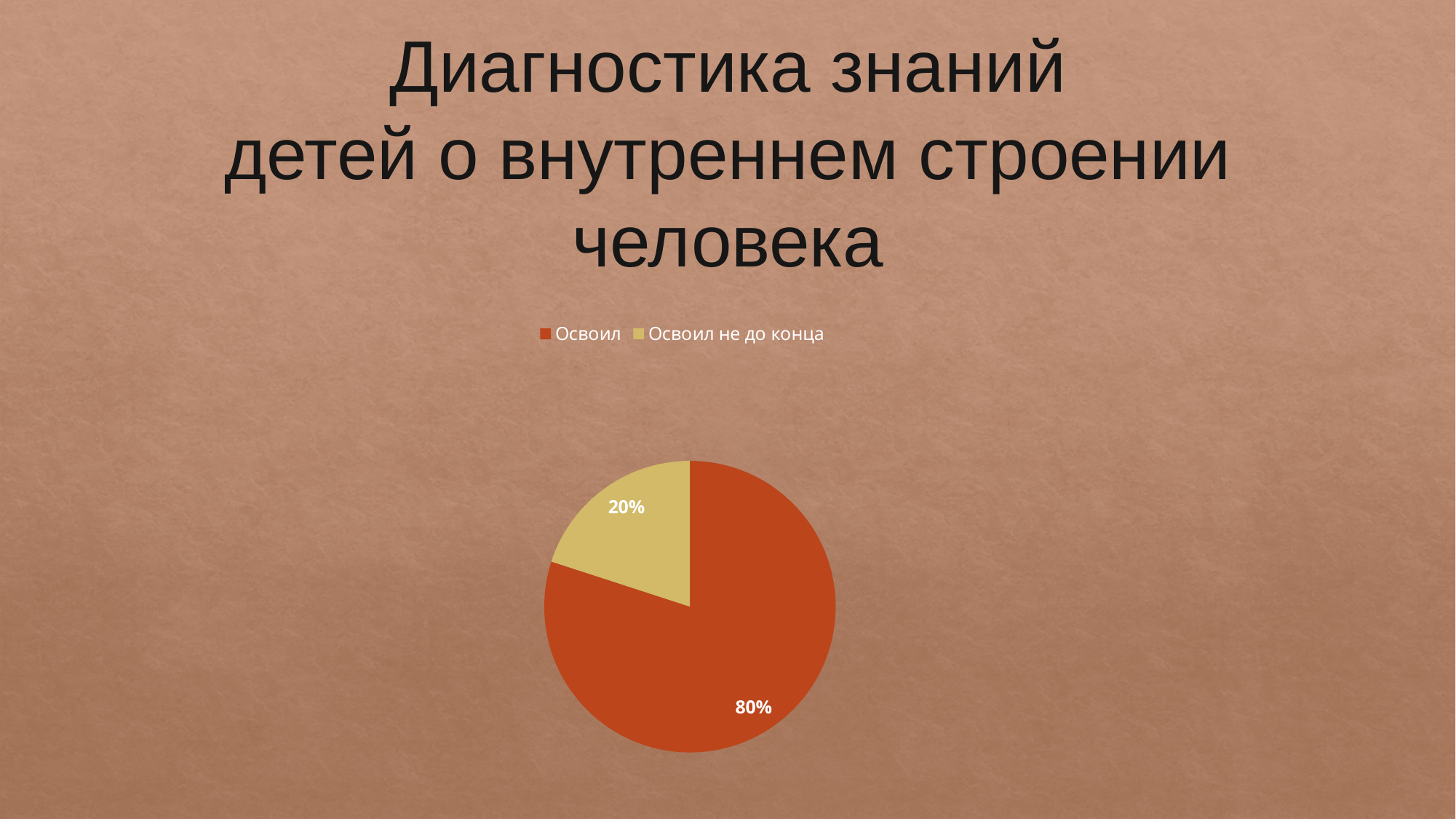
Which slice of the pie is the largest? Освоил What colour is the "Освоил" slice? red-orange What share of the pie does "Освоил не до конца" take? 20% What colour is the "Освоил не до конца" slice? yellow Which is larger: the "Освоил" slice or the "Освоил не до конца" slice? Освоил What kind of chart is shown on the slide? pie chart Which slice of the pie is the smallest? Освоил не до конца What share of the pie does "Освоил" take? 80% What is the difference between the "Освоил" and "Освоил не до конца" shares? 60% How many slices does the pie chart have? 2 How many entries does the legend list? 2